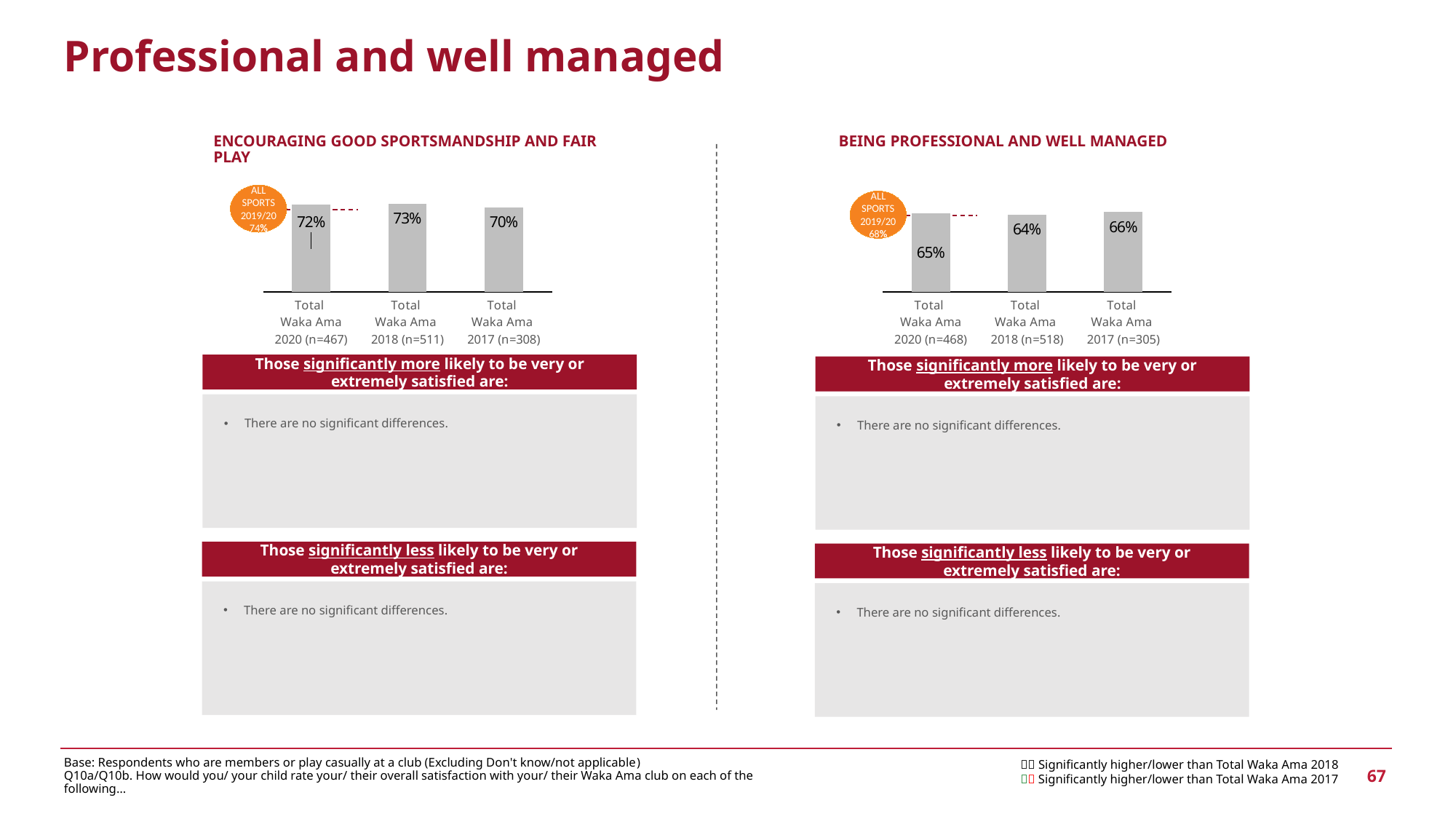
What type of chart is used in the 'Being professional and well managed' section? Bar chart In the 'Encouraging good sportsmanship and fair play' chart, which category has the highest value? Total Waka Ama 2018 (n=511) In the 'Encouraging good sportsmanship and fair play' chart, what is the difference between the 2018 and 2017 values? 3% In the 'Encouraging good sportsmanship and fair play' chart, what is the value for Total Waka Ama 2017 (n=308)? 70% In the 'Being professional and well managed' chart, what is the All Sports 2019/20 benchmark value shown in the orange circle? 68% In the 'Being professional and well managed' chart, what is the value for Total Waka Ama 2018 (n=518)? 64% In the 'Being professional and well managed' chart, which category has the lowest value? Total Waka Ama 2018 (n=518) In the 'Being professional and well managed' chart, what is the value for Total Waka Ama 2020 (n=468)? 65% In the 'Being professional and well managed' chart, what is the difference between the 2017 and 2020 values? 1% In the 'Being professional and well managed' chart, which is larger: the value for 2017 or the value for 2018? 2017 How many bars are shown in the 'Encouraging good sportsmanship and fair play' chart? 3 In the 'Encouraging good sportsmanship and fair play' chart, what is the value for Total Waka Ama 2020 (n=467)? 72%